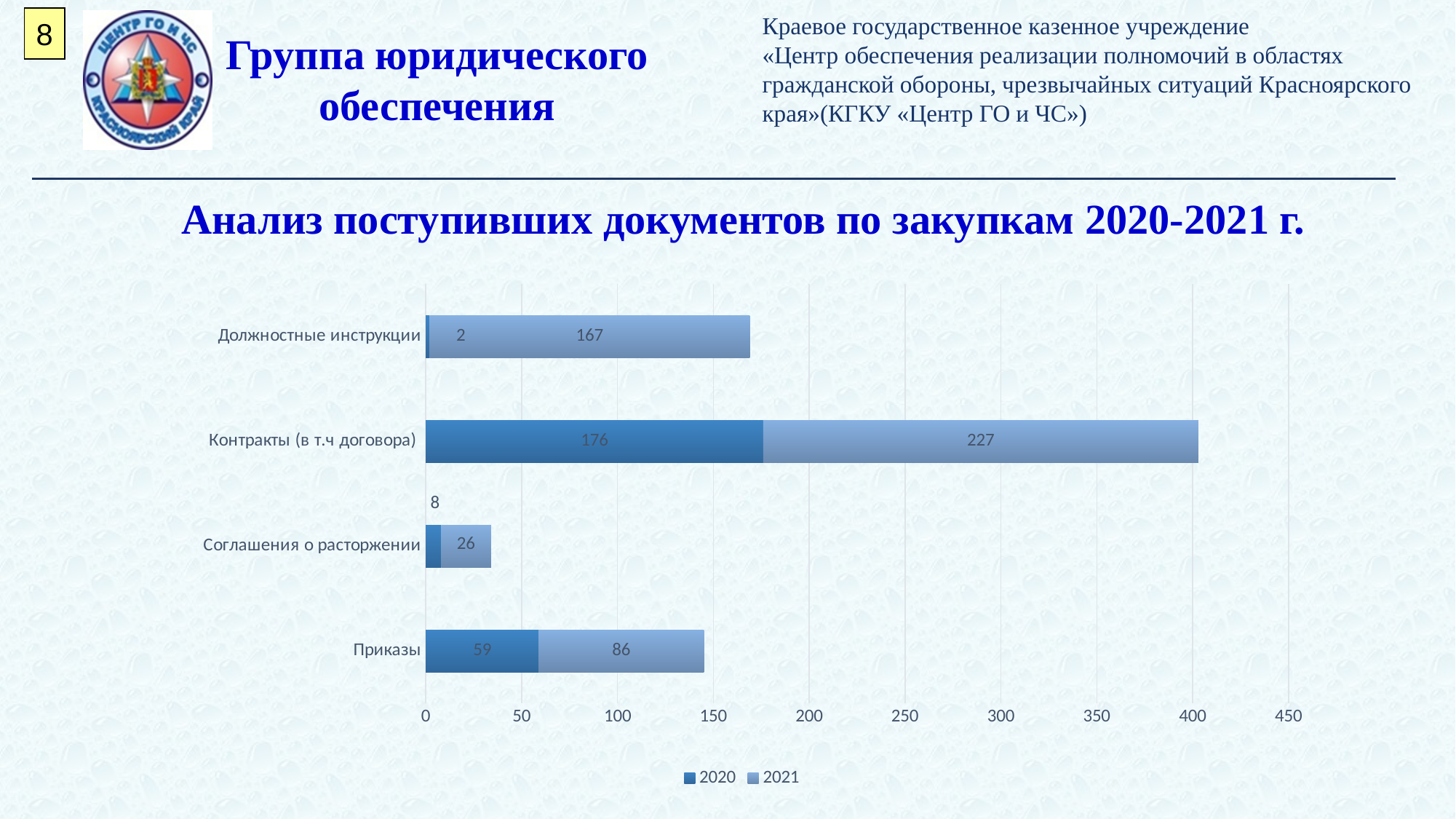
What is the total of the stacked bar for Приказы? 145 What is the 2021 value for Соглашения о расторжении? 26 How many categories are shown on the chart? 4 Which is larger for Приказы: the 2020 value or the 2021 value? 2021 What is the 2020 value for Должностные инструкции? 2 Which category has the lowest 2020 value? Должностные инструкции What is the difference between the 2021 and 2020 values for Контракты (в т.ч договора)? 51 Which category has the highest 2021 value? Контракты (в т.ч договора) What kind of chart is shown on the slide? Stacked bar chart How many series does the legend list? 2 What is the 2020 value for Приказы? 59 What is the 2021 value for Контракты (в т.ч договора)? 227